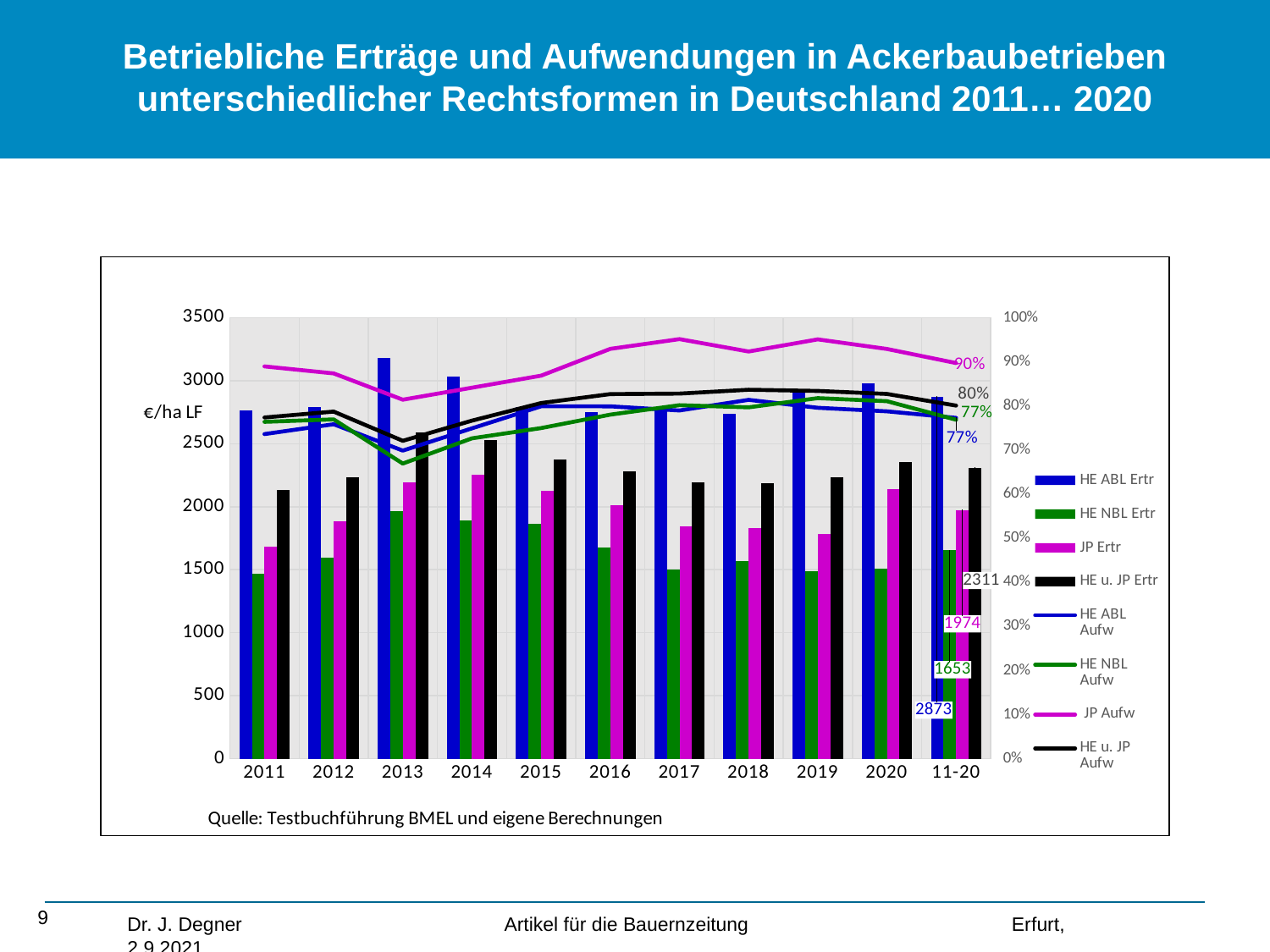
What is the value of HE u. JP Ertr for the 11-20 category? 2311 What percentage is shown for JP Aufw at the 11-20 category? 90% What is the value of JP Ertr for the 11-20 category? 1974 How many categories are shown on the x axis? 11 For the 11-20 category, which is larger: JP Ertr or HE u. JP Ertr? HE u. JP Ertr Is the HE ABL Ertr value for 2013 greater or less than 3000? greater What percentage is shown for HE u. JP Aufw at the 11-20 category? 80% What is the value of HE ABL Ertr for the 11-20 category? 2873 In which year is the HE ABL Ertr bar the highest? 2013 What is the value of HE NBL Ertr for the 11-20 category? 1653 How many series does the legend list? 8 For the 11-20 category, what is the difference between HE ABL Ertr and HE NBL Ertr? 1220